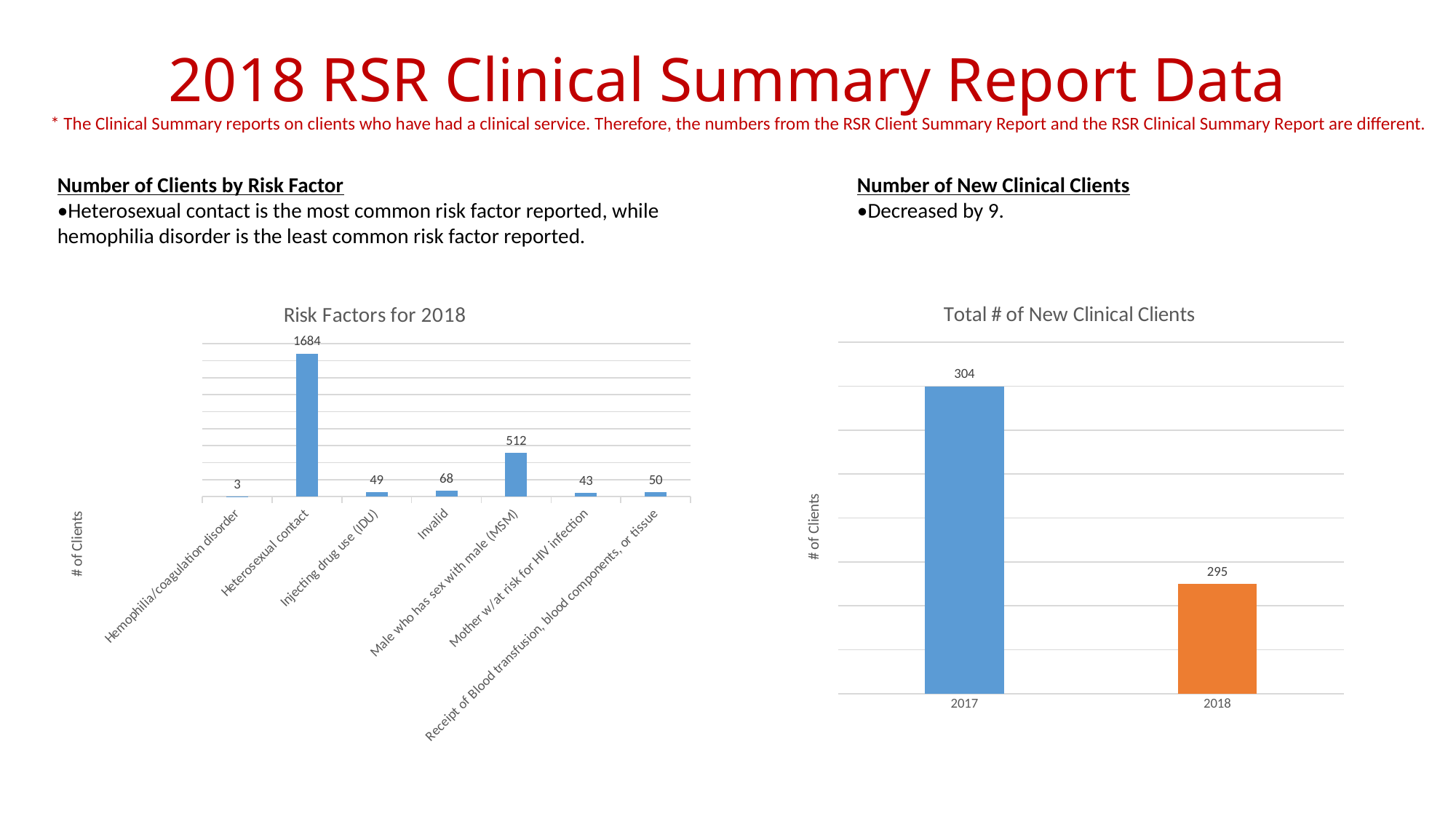
What type of chart is the 'Total # of New Clinical Clients' chart? bar chart In the 'Risk Factors for 2018' chart, which risk factor has the lowest value? Hemophilia/coagulation disorder In the 'Total # of New Clinical Clients' chart, what is the difference between 2017 and 2018? 9 In the 'Risk Factors for 2018' chart, which risk factor has the highest value? Heterosexual contact In the 'Risk Factors for 2018' chart, what is the value for Heterosexual contact? 1684 In the 'Risk Factors for 2018' chart, what is the value for Male who has sex with male (MSM)? 512 In the 'Total # of New Clinical Clients' chart, what is the value for 2017? 304 In the 'Risk Factors for 2018' chart, how many risk factor categories are shown? 7 In the 'Risk Factors for 2018' chart, what is the difference between the values for Invalid and Mother w/at risk for HIV infection? 25 In the 'Total # of New Clinical Clients' chart, do the values rise or fall from 2017 to 2018? fall In the 'Risk Factors for 2018' chart, what is the value for Injecting drug use (IDU)? 49 In the 'Risk Factors for 2018' chart, which is larger: Receipt of Blood transfusion, blood components, or tissue or Injecting drug use (IDU)? Receipt of Blood transfusion, blood components, or tissue